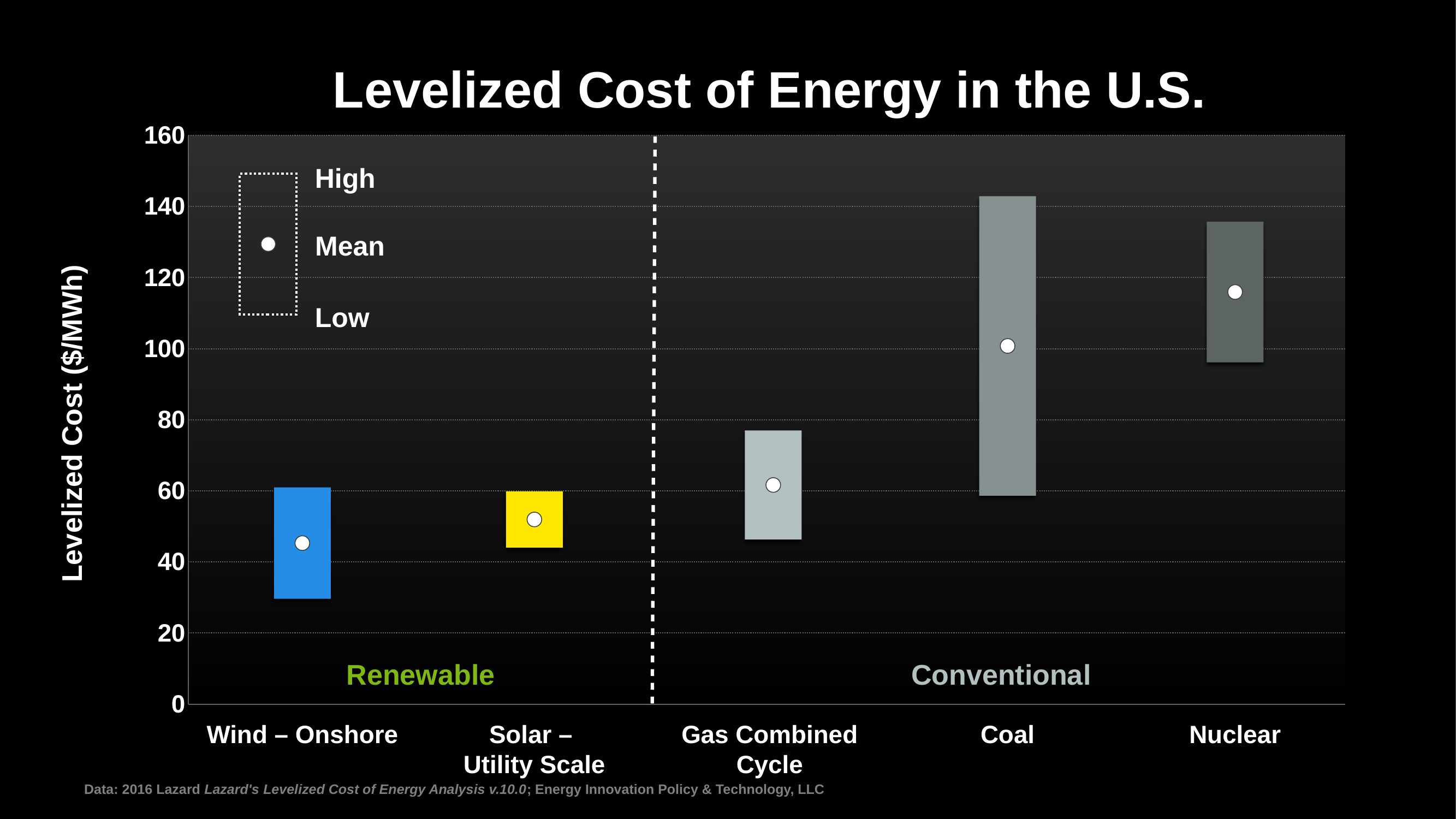
What kind of chart is shown on the slide? Bar chart Is the mean levelized cost for Nuclear greater or less than 100? greater Is the 'Low' value for Coal greater or less than 40? greater Is the mean levelized cost for Wind – Onshore greater or less than 60? less How many energy sources are plotted on the x axis? 5 Which has the higher mean levelized cost, Gas Combined Cycle or Nuclear? Nuclear Which energy source has the lowest mean levelized cost? Wind – Onshore Which energy source has the highest 'High' value? Coal What is the label of the y axis? Levelized Cost ($/MWh) What is the title of the chart? Levelized Cost of Energy in the U.S. Which energy source has the highest mean levelized cost? Nuclear Which energy source has the lowest 'Low' value? Wind – Onshore